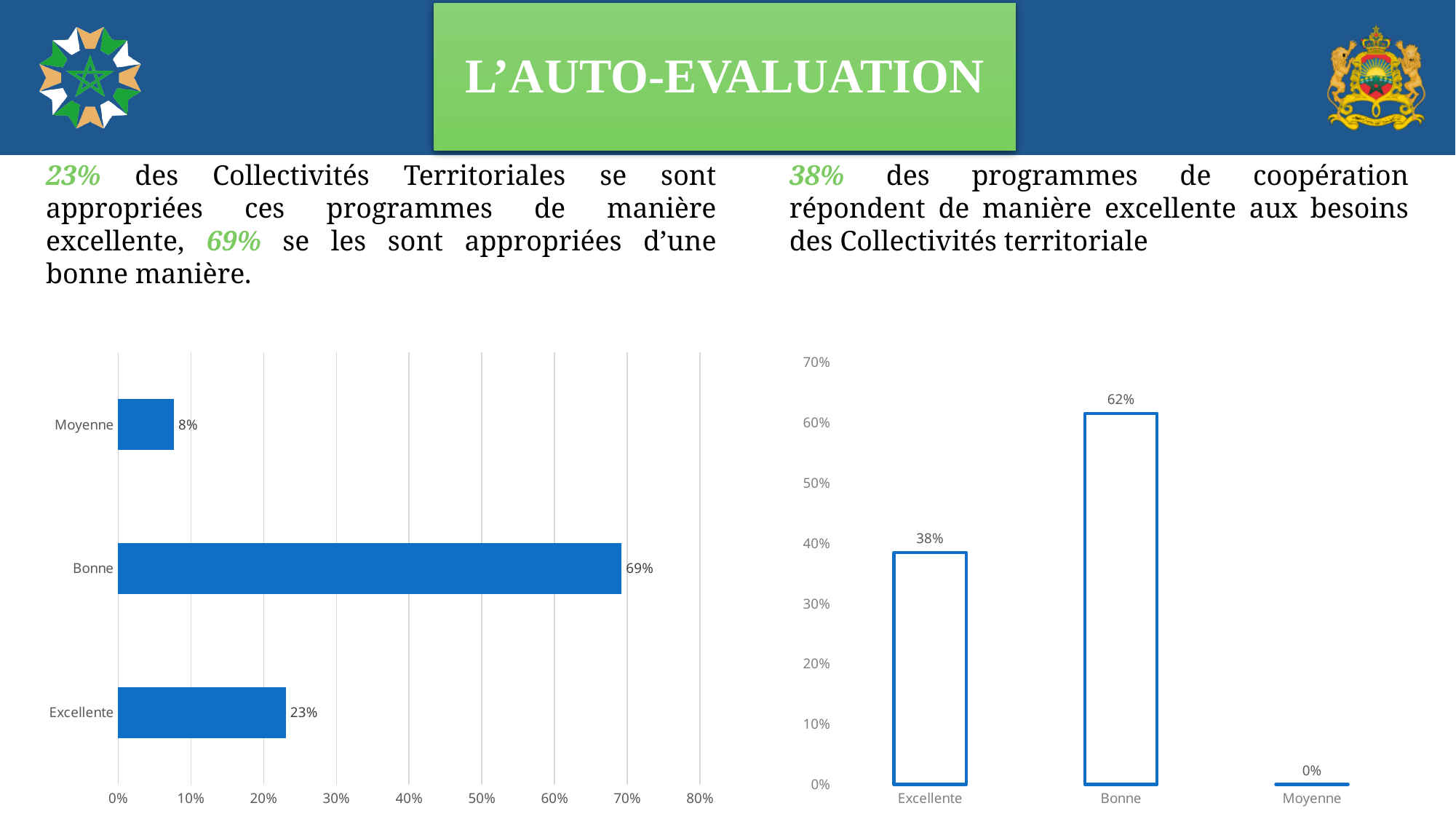
In the right chart, what is the value for Moyenne? 0% In the right chart, what is the value for Bonne? 62% In the left chart, which category has the highest value? Bonne In the right chart, which is larger, the value for Excellente or the value for Bonne? Bonne In the left chart, what is the value for Bonne? 69% In the left chart, which category has the lowest value? Moyenne In the left chart, what is the difference between the values for Bonne and Excellente? 46% In the left chart, what is the value for Moyenne? 8% In the right chart, what is the value for Excellente? 38% In the right chart, what is the difference between the values for Bonne and Excellente? 24% In the left chart, how many categories are shown? 3 What kind of chart is the left chart? Bar chart